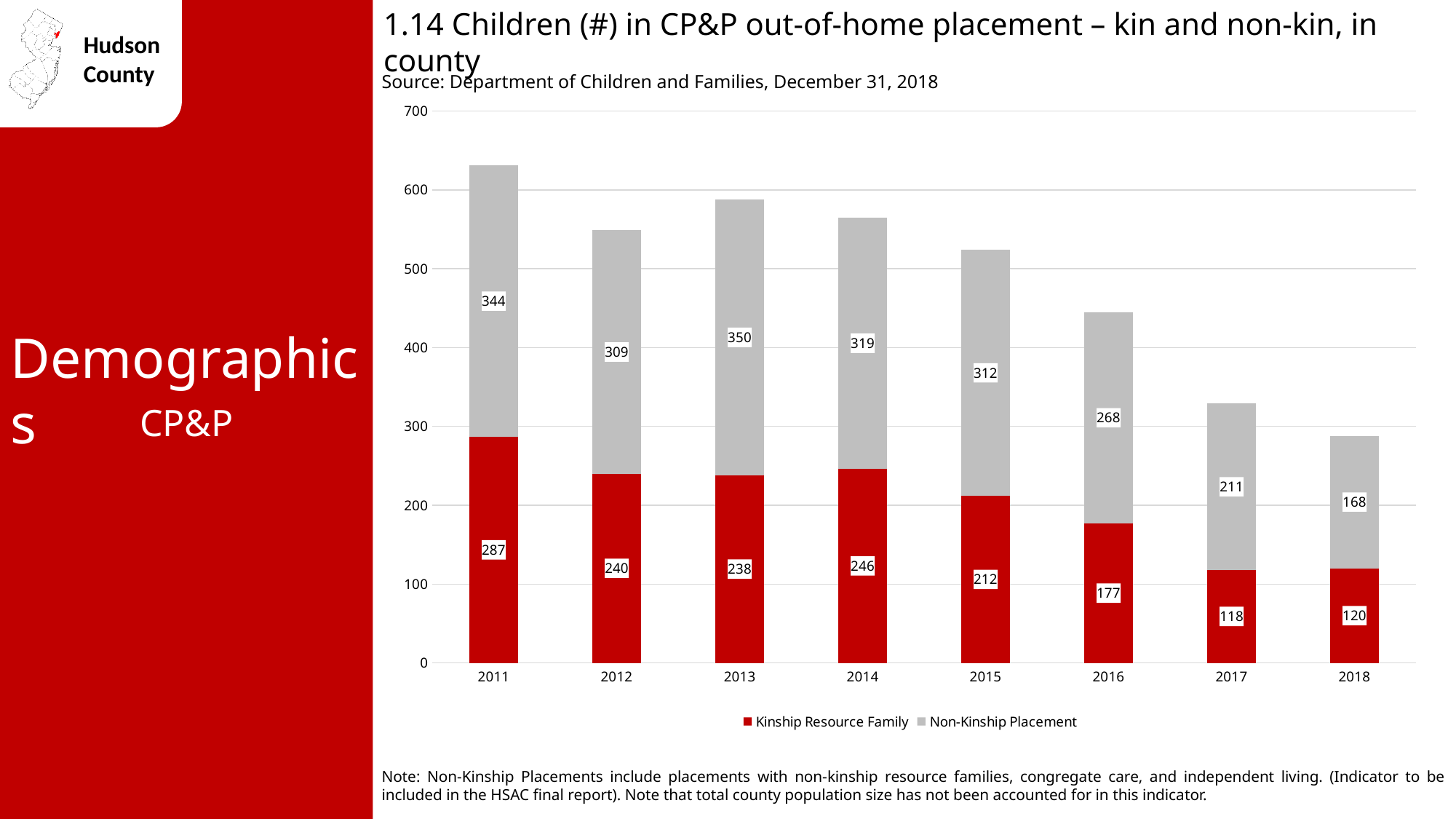
Which year has the lowest Kinship Resource Family value? 2017 What is the Kinship Resource Family value for 2017? 118 How many years are shown on the x axis? 8 What is the total of the stacked bar for 2018? 288 Which year has the highest Non-Kinship Placement value? 2013 What is the difference between the Non-Kinship Placement values for 2011 and 2018? 176 What is the total of the stacked bar for 2016? 445 What is the Non-Kinship Placement value for 2013? 350 What is the Kinship Resource Family value for 2011? 287 How many series does the legend list? 2 What kind of chart is shown? Stacked bar chart Which is larger: the Kinship Resource Family value for 2014 or for 2015? 2014